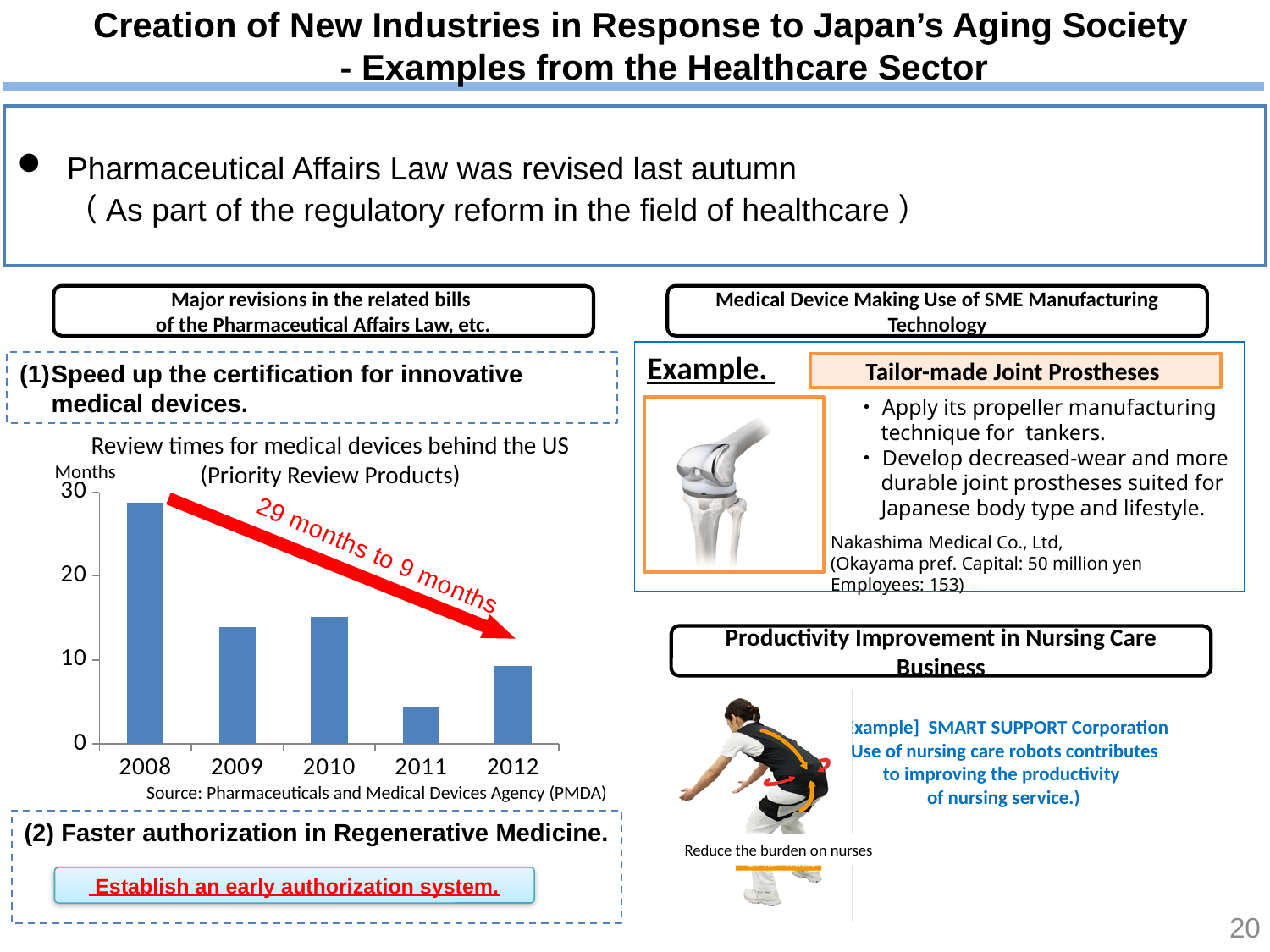
What is the source cited for the review times chart? Pharmaceuticals and Medical Devices Agency (PMDA) Is the review time for 2012 greater or less than 10 months? less Which year has the lowest review time in the chart? 2011 What unit is shown on the y axis of the review times chart? Months Which year has a longer review time, 2008 or 2012? 2008 Which year has the highest review time in the chart? 2008 What type of chart is used to show review times for medical devices? bar chart How many years are shown on the x axis of the review times chart? 5 Is the review time for 2009 greater or less than 10 months? greater Is the review time for 2011 greater or less than 10 months? less Do review times generally rise or fall from 2008 to 2012? fall